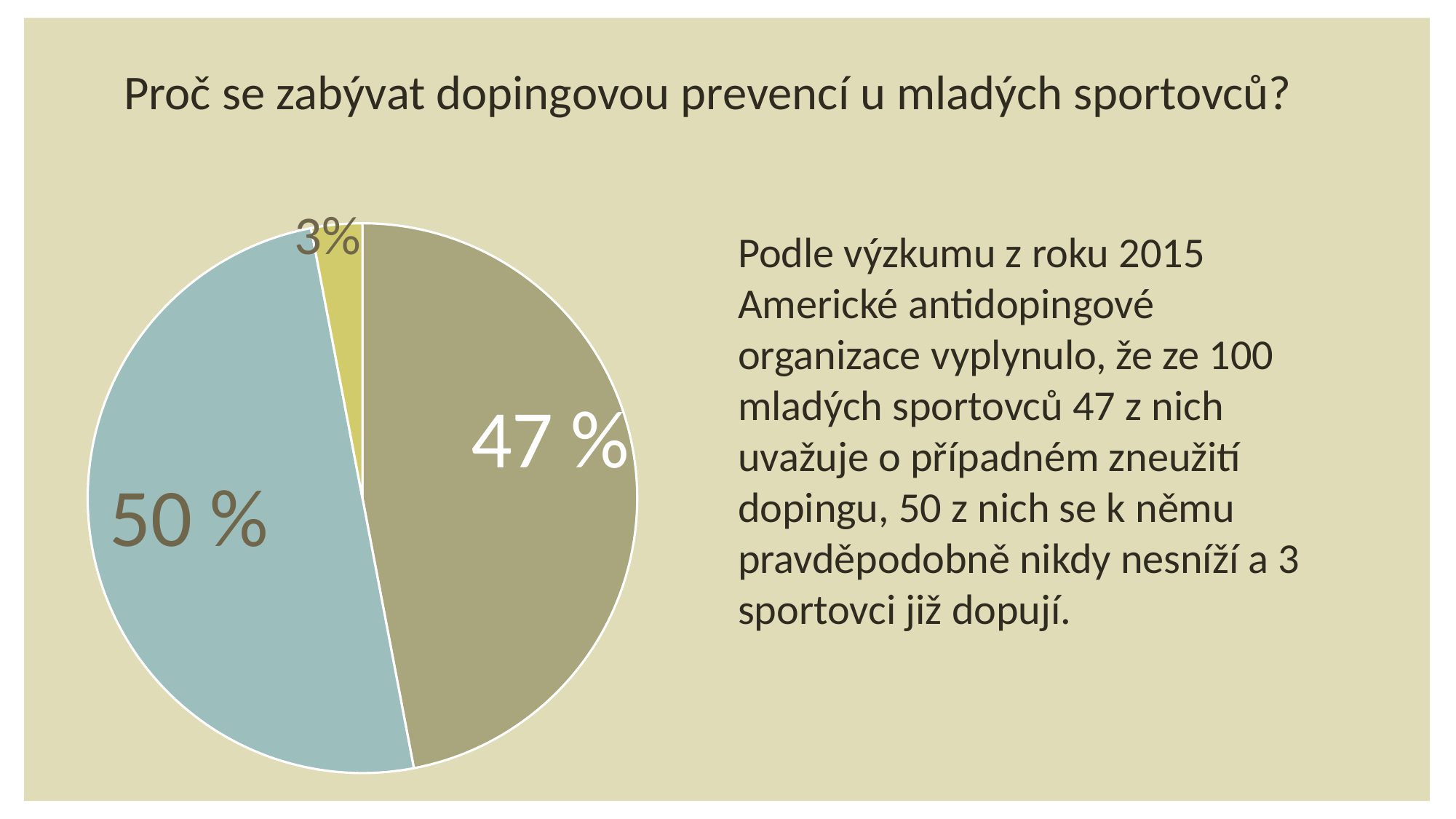
What is the value shown on the smallest slice of the pie chart? 3% What is the difference between the 50 % slice and the 47 % slice? 3 % What value is printed on the yellow slice of the pie chart? 3% What kind of chart is shown on the slide? pie chart How many slices does the pie chart have? 3 What value is printed on the blue slice of the pie chart? 50 % What colour is the smallest slice of the pie chart? yellow What do the three slice values of the pie chart add up to? 100 % What is the difference between the 47 % slice and the 3% slice? 44 % What is the value shown on the largest slice of the pie chart? 50 % Which slice is larger, the blue slice or the olive slice? the blue slice What value is printed on the olive-coloured slice of the pie chart? 47 %